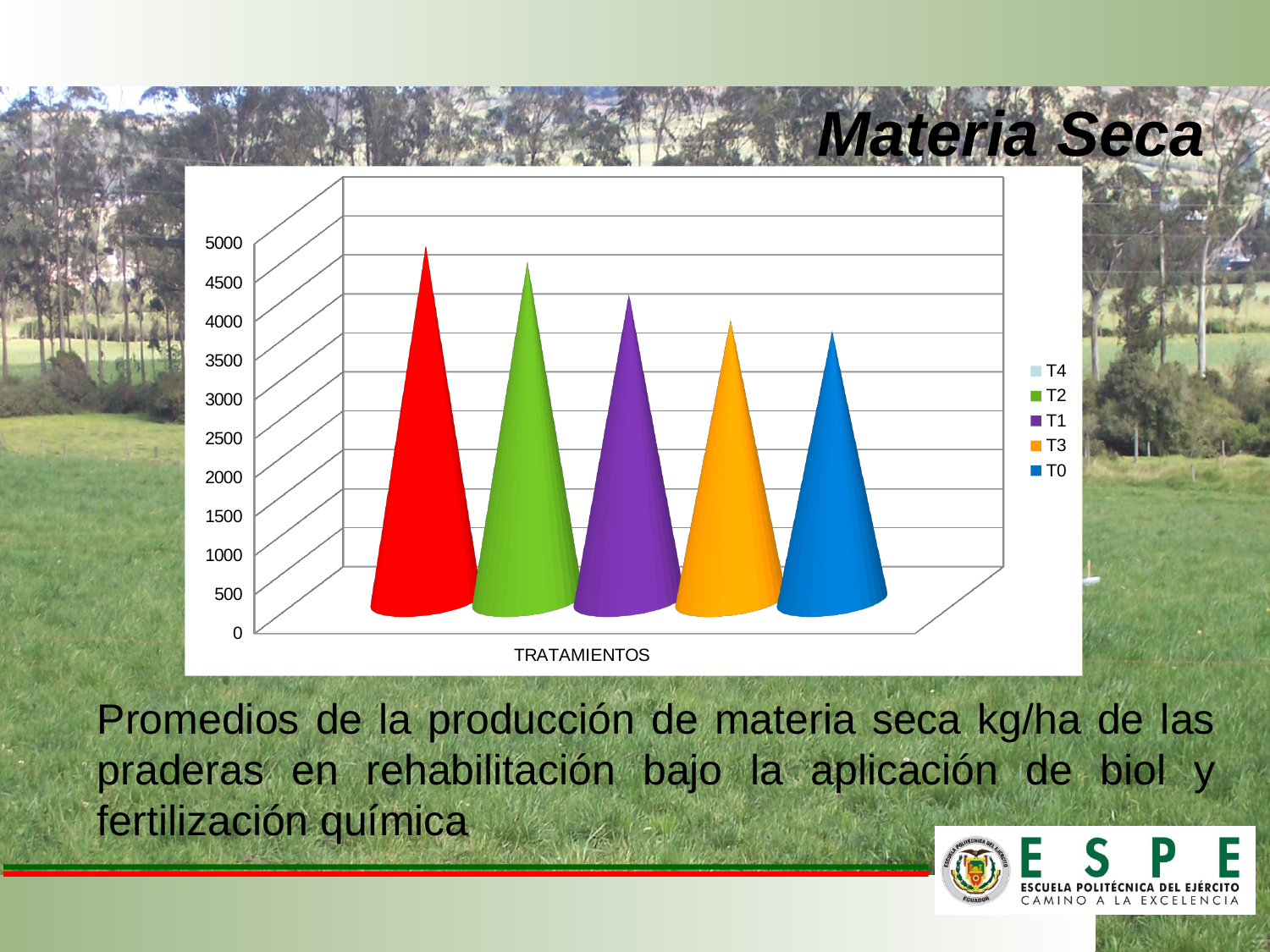
Is the value for T2 (green cone) greater or less than 4000? greater Is the value for T3 (orange cone) greater or less than 4500? less Do the cone heights rise or fall from left to right across the chart? fall What is the title of the chart? Materia Seca Which cone is the tallest in the chart? the red cone (leftmost) What kind of chart is shown on the slide? bar chart Which is larger, the value for T2 (green) or the value for T0 (blue)? T2 Which cone is the lowest in the chart? T0 (the blue cone) Is the value for T0 (blue cone) greater or less than 3000? greater What label is shown on the horizontal axis of the chart? TRATAMIENTOS How many series does the legend list? 5 How many cones (bars) are plotted in the chart? 5